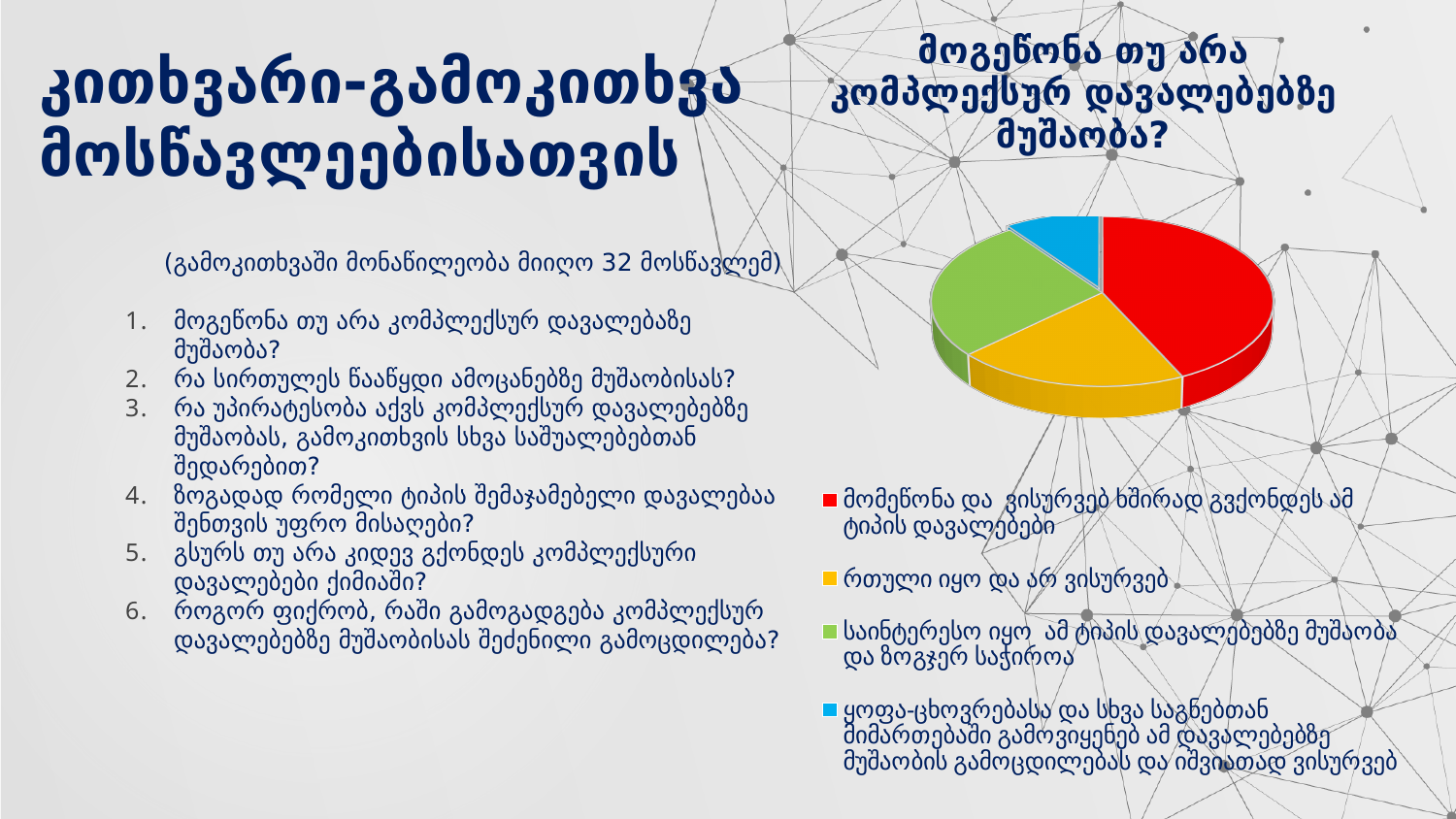
Which slice is larger: 'რთული იყო და არ ვისურვებ' or 'ყოფა-ცხოვრებასა და სხვა საგნებთან მიმართებაში გამოვიყენებ ამ დავალებებზე მუშაობის გამოცდილებას და იმვიათად ვისურვებ'? რთული იყო და არ ვისურვებ How many slices does the pie chart have? 4 What colour is the slice for 'რთული იყო და არ ვისურვებ' in the pie chart? yellow How many entries does the legend of the pie chart list? 4 What is the title of the pie chart? მოგეწონა თუ არა კომპლექსურ დავალებებზე მუშაობა? Which category has the largest slice in the pie chart? მომეწონა და ვისურვებ ხშირად გვქონდეს ამ ტიპის დავალებები Which slice is larger: 'საინტერესო იყო ამ ტიპის დავალებებზე მუშაობა და ზოგჯერ საჭიროა' or 'ყოფა-ცხოვრებასა და სხვა საგნებთან მიმართებაში გამოვიყენებ ამ დავალებებზე მუშაობის გამოცდილებას და იმვიათად ვისურვებ'? საინტერესო იყო ამ ტიპის დავალებებზე მუშაობა და ზოგჯერ საჭიროა Which category has the smallest slice in the pie chart? ყოფა-ცხოვრებასა და სხვა საგნებთან მიმართებაში გამოვიყენებ ამ დავალებებზე მუშაობის გამოცდილებას და იშვიათად ვისურვებ Which slice is larger: 'მომეწონა და ვისურვებ ხშირად გვქონდეს ამ ტიპის დავალებები' or 'რთული იყო და არ ვისურვებ'? მომეწონა და ვისურვებ ხშირად გვქონდეს ამ ტიპის დავალებები What kind of chart is shown on the slide? pie chart